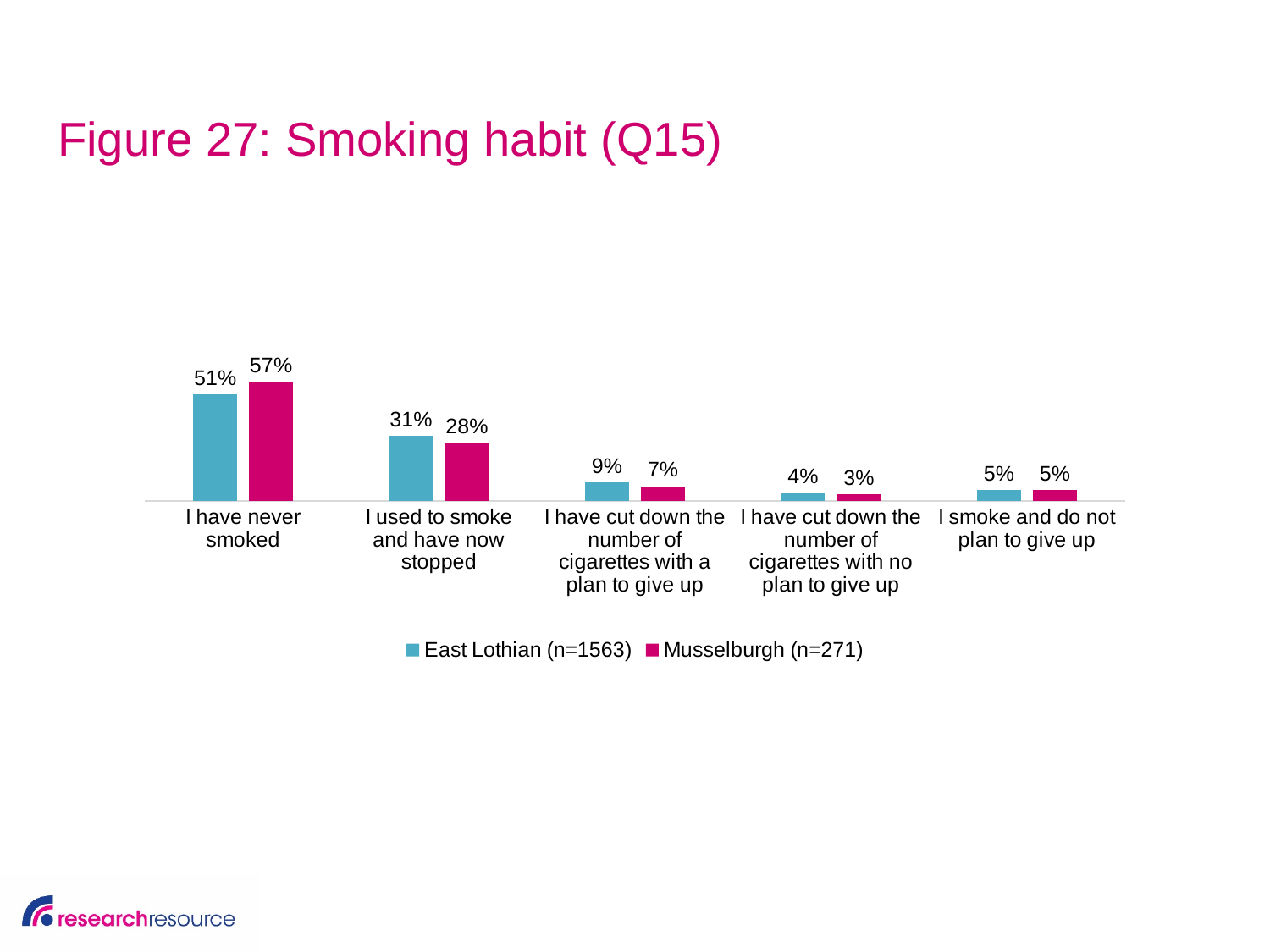
Which category has the highest value for Musselburgh? I have never smoked What percentage of Musselburgh respondents said 'I used to smoke and have now stopped'? 28% For 'I have cut down the number of cigarettes with a plan to give up', which is larger: East Lothian or Musselburgh? East Lothian What is the Musselburgh value for 'I have cut down the number of cigarettes with a plan to give up'? 7% What kind of chart is shown on the slide? Bar chart What is the difference between the Musselburgh and East Lothian values for 'I have never smoked'? 6% Which category has the lowest value for Musselburgh? I have cut down the number of cigarettes with no plan to give up What is the sample size (n) for Musselburgh shown in the legend? 271 How many series does the legend list? 2 What percentage of East Lothian respondents said 'I have never smoked'? 51% How many categories are shown on the x axis? 5 What is the difference between the East Lothian and Musselburgh values for 'I used to smoke and have now stopped'? 3%